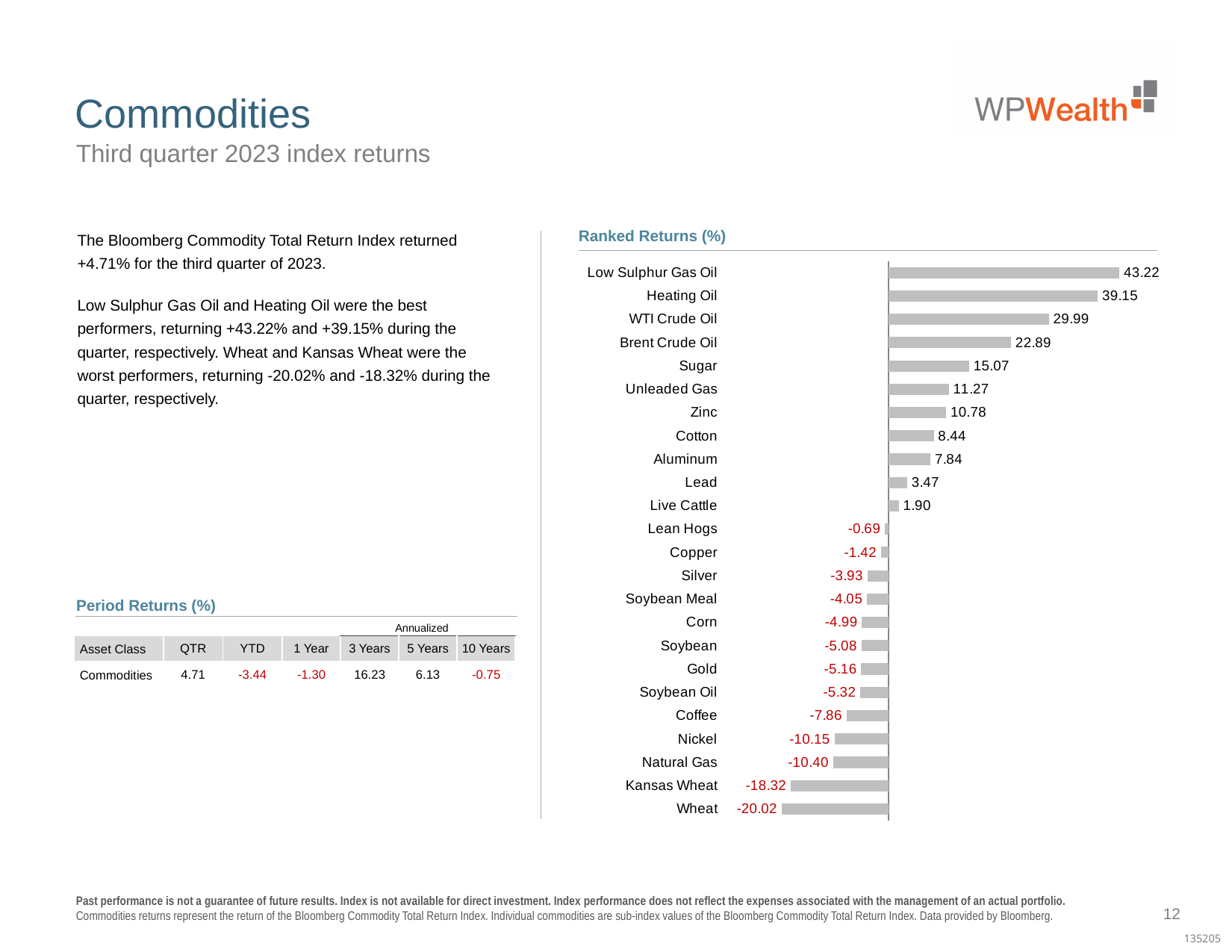
What is the difference between the values for WTI Crude Oil and Brent Crude Oil in the Ranked Returns (%) chart? 7.10 How many categories are shown in the Ranked Returns (%) chart? 24 What is the value for Sugar in the Ranked Returns (%) chart? 15.07 Which category has the lowest value in the Ranked Returns (%) chart? Wheat Which has a larger value in the Ranked Returns (%) chart, Coffee or Nickel? Coffee What is the difference between the values for Low Sulphur Gas Oil and Heating Oil in the Ranked Returns (%) chart? 4.07 Which has a larger value in the Ranked Returns (%) chart, Zinc or Cotton? Zinc What kind of chart is the Ranked Returns (%) chart? Bar chart What is the value for Copper in the Ranked Returns (%) chart? -1.42 What is the value for Natural Gas in the Ranked Returns (%) chart? -10.40 Which category has the highest value in the Ranked Returns (%) chart? Low Sulphur Gas Oil What is the value for Heating Oil in the Ranked Returns (%) chart? 39.15